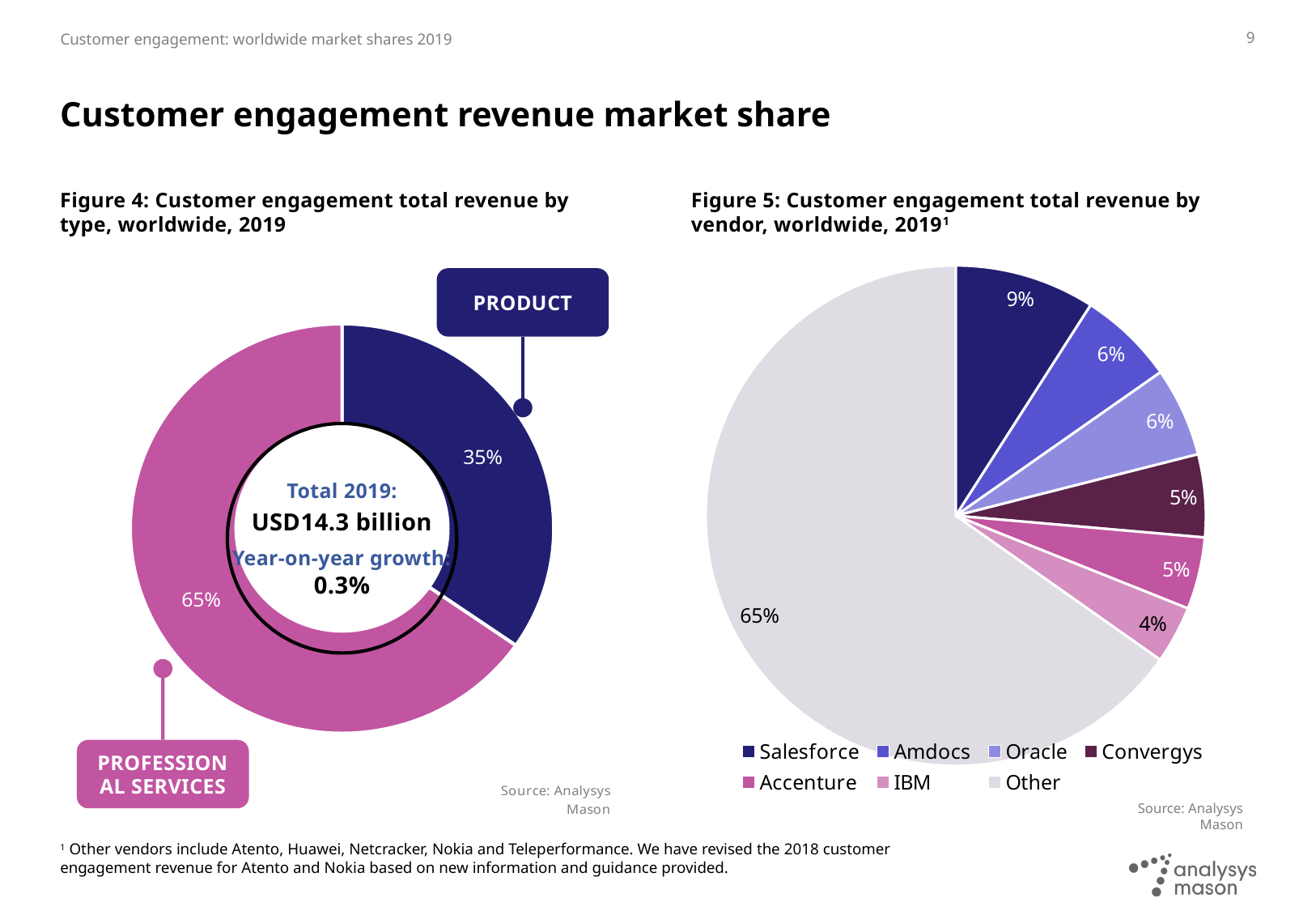
In Figure 4, what is the difference in percentage points between the Professional Services share and the Product share? 30 percentage points In Figure 4, what share of customer engagement total revenue comes from Professional Services? 65% In Figure 5, what share of customer engagement total revenue does Salesforce hold? 9% In Figure 4, what is the total 2019 customer engagement revenue shown in the centre of the chart? USD14.3 billion In Figure 4, which revenue type has the larger share, Product or Professional Services? Professional Services In Figure 5, which vendor has the smallest share? IBM In Figure 5, how many categories does the legend list? 7 In Figure 5, what is the difference in percentage points between Salesforce's share and Convergys's share? 4 percentage points In Figure 4, what share of customer engagement total revenue comes from Product? 35% In Figure 5, what share of customer engagement total revenue does IBM hold? 4% What kind of chart is Figure 5? Pie chart In Figure 5, which named vendor (excluding Other) has the largest share? Salesforce